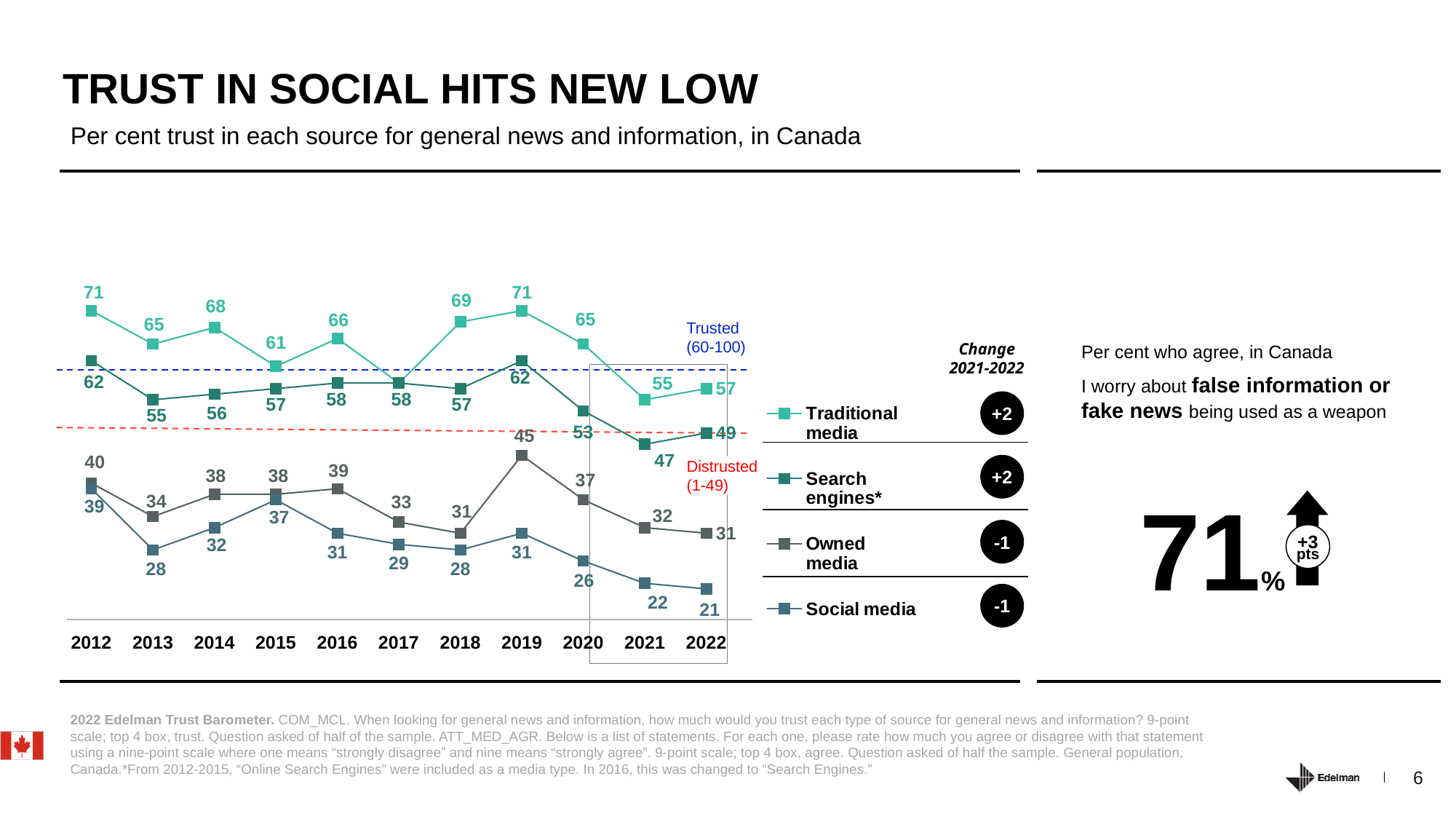
Which is larger in 2019, Owned media or Search engines? Search engines How many years are shown along the x axis of the chart? 11 What kind of chart is shown on the slide? line chart How many series does the chart's legend list? 4 What is the value for Traditional media in 2019? 71 In which year is the Traditional media value lowest? 2021 What is the value for Search engines in 2021? 47 What is the value for Owned media in 2012? 40 Does the Social media value rise or fall from 2019 to 2022? fall What is the difference between Traditional media and Social media in 2022? 36 In which year is the Social media value highest? 2012 What is the value for Social media in 2022? 21